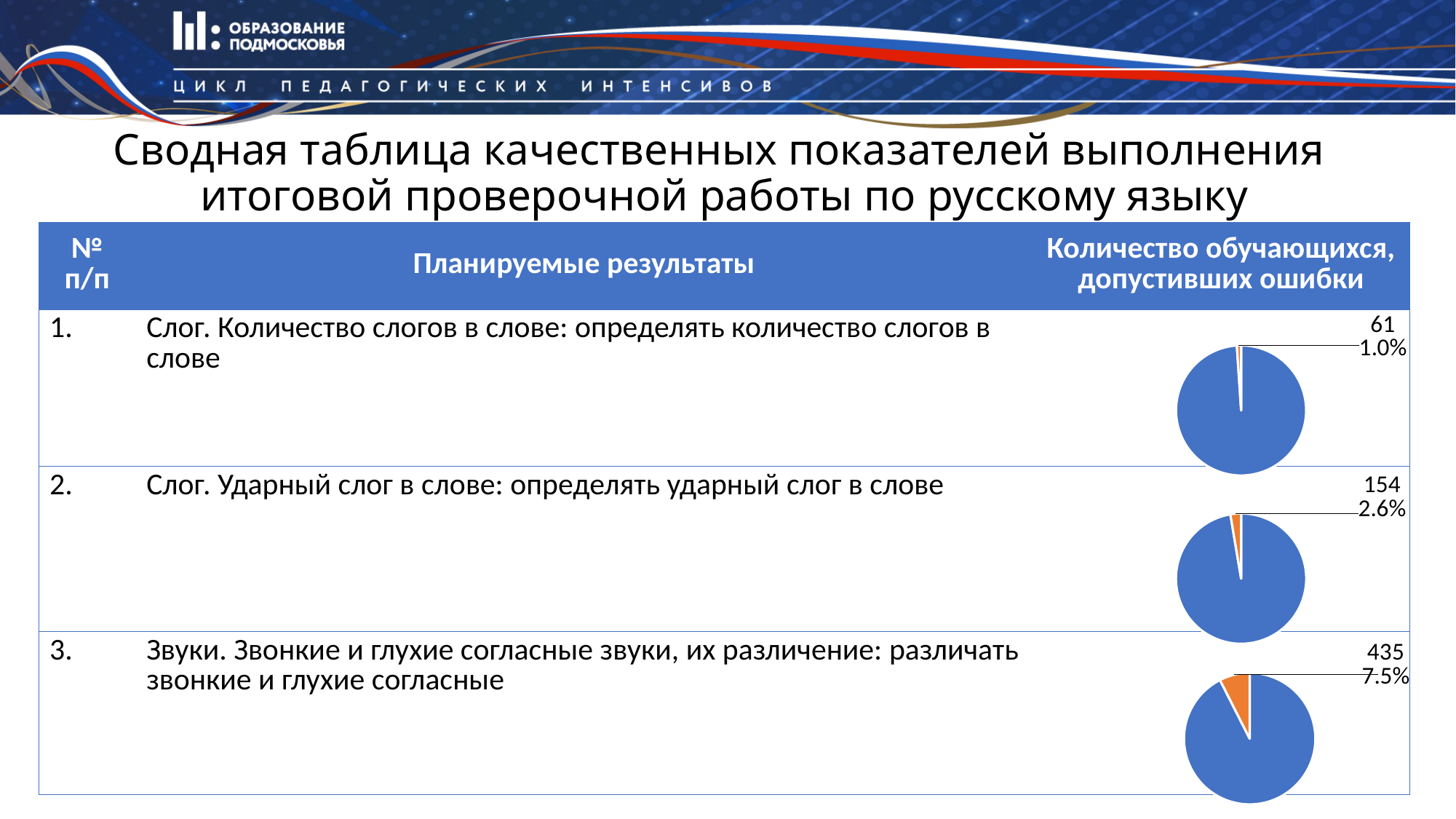
Is the orange slice in the middle pie chart (row 2) larger or smaller than the orange slice in the bottom pie chart (row 3)? smaller In the top pie chart (row 1), what is the data label on the orange slice? 61 1.0% Which of the three pie charts has the largest orange slice? the bottom one (row 3) What is the difference between the number shown on the orange slice in row 3 and the number shown in row 2? 281 In the middle pie chart (row 2), what percentage is shown for the orange slice? 2.6% Which of the three pie charts has the smallest orange slice? the top one (row 1) What kind of chart is shown in row 1 of the table? pie chart What colour is the large slice in each pie chart? blue In the bottom pie chart (row 3), what number is shown on the orange slice? 435 What is the difference in percentage between the orange slice in row 2 and the orange slice in row 1? 1.6% How many pie charts are on the slide? 3 In the bottom pie chart (row 3), what share of the pie does the orange slice represent? 7.5%